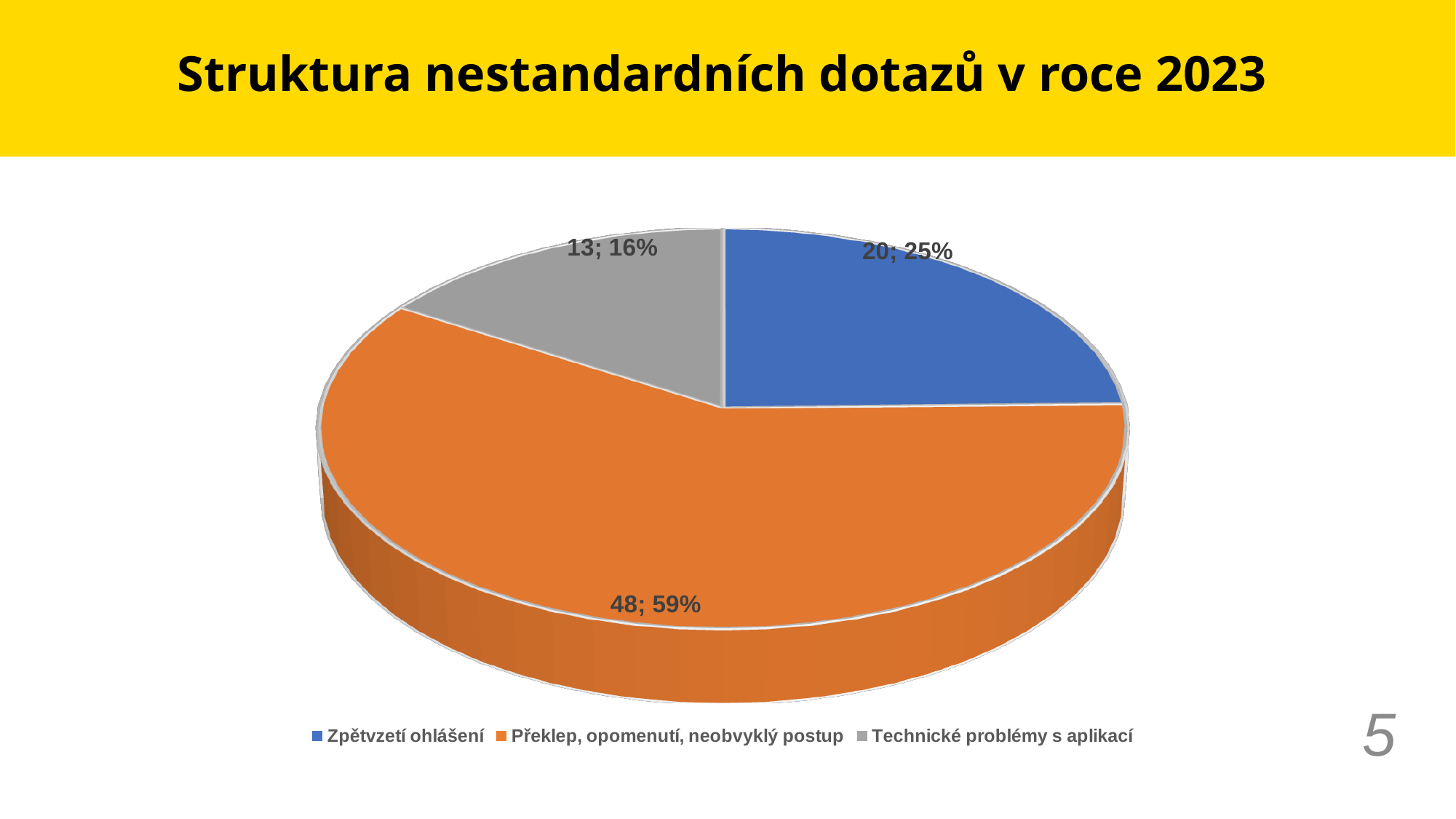
What kind of chart is shown on the slide? pie chart What is the title of the chart? Struktura nestandardních dotazů v roce 2023 What is the value for Technické problémy s aplikací? 13 What is the value for Zpětvzetí ohlášení? 20 How many slices does the pie chart have? 3 Which category has the largest slice? Překlep, opomenutí, neobvyklý postup Which category has the smallest slice? Technické problémy s aplikací What share of the pie does Překlep, opomenutí, neobvyklý postup represent? 59% What is the difference between the values for Překlep, opomenutí, neobvyklý postup and Zpětvzetí ohlášení? 28 What is the value for Překlep, opomenutí, neobvyklý postup? 48 How many entries does the legend list? 3 What share of the pie does Technické problémy s aplikací represent? 16%